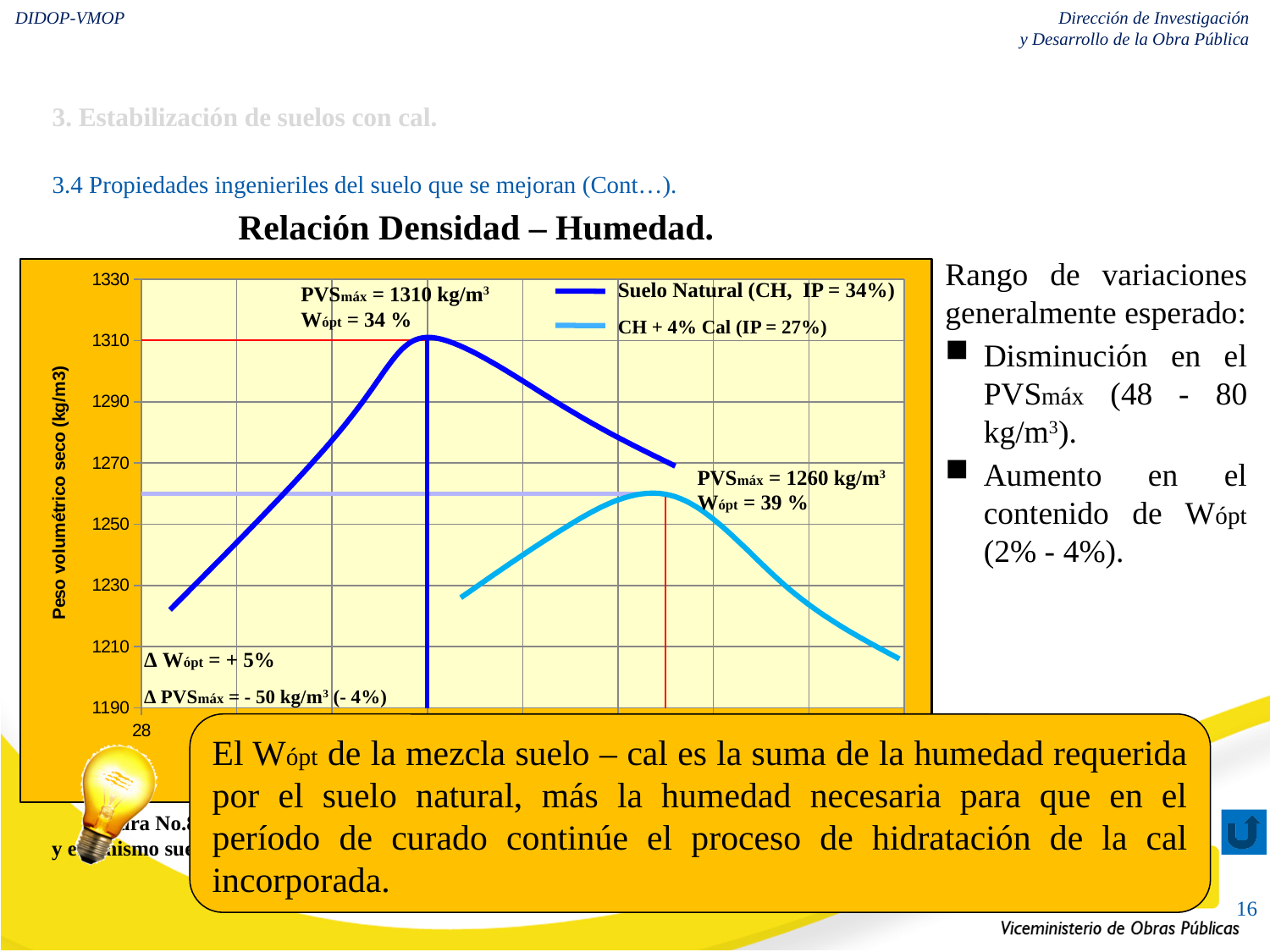
What is the Wópt value annotated for the Suelo Natural curve? 34 % How many series does the chart legend list? 2 What is the PVSmáx value annotated for the Suelo Natural curve? 1310 kg/m³ What is the Wópt value annotated for the CH + 4% Cal curve? 39 % What is the difference between the PVSmáx of Suelo Natural and the PVSmáx of CH + 4% Cal? 50 kg/m³ What is the title shown above the chart? Relación Densidad – Humedad. Which series reaches the higher maximum dry unit weight, Suelo Natural or CH + 4% Cal? Suelo Natural What is the PVSmáx value annotated for the CH + 4% Cal curve? 1260 kg/m³ By how much does Wópt increase from Suelo Natural to CH + 4% Cal? 5% What kind of chart is shown on the slide? line chart What is the label of the vertical axis of the chart? Peso volumétrico seco (kg/m3) Is the value at the right end of the CH + 4% Cal curve greater or less than 1230? less